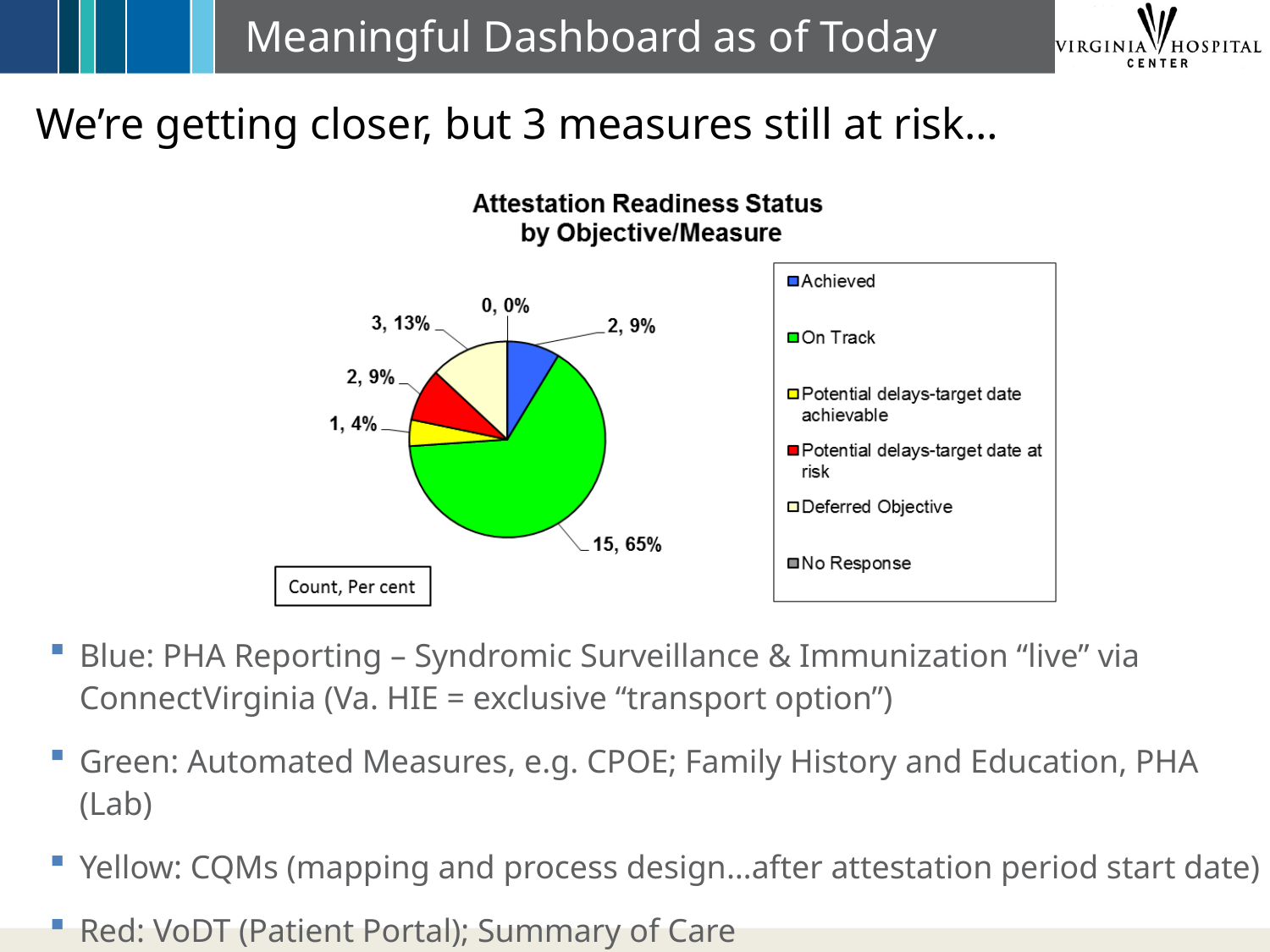
What is the title of the chart? Attestation Readiness Status by Objective/Measure What percentage share of the pie does Deferred Objective represent? 13% What is the count for the On Track category? 15 What kind of chart is shown on the slide? Pie chart What is the count for the Achieved category? 2 What is the difference in count between On Track and Deferred Objective? 12 Which has a larger count, Deferred Objective or Potential delays-target date achievable? Deferred Objective How many categories does the chart's legend list? 6 Which category has the largest share of the pie? On Track What percentage share of the pie does On Track represent? 65% What is the count for the No Response category? 0 What is the count for the Deferred Objective category? 3